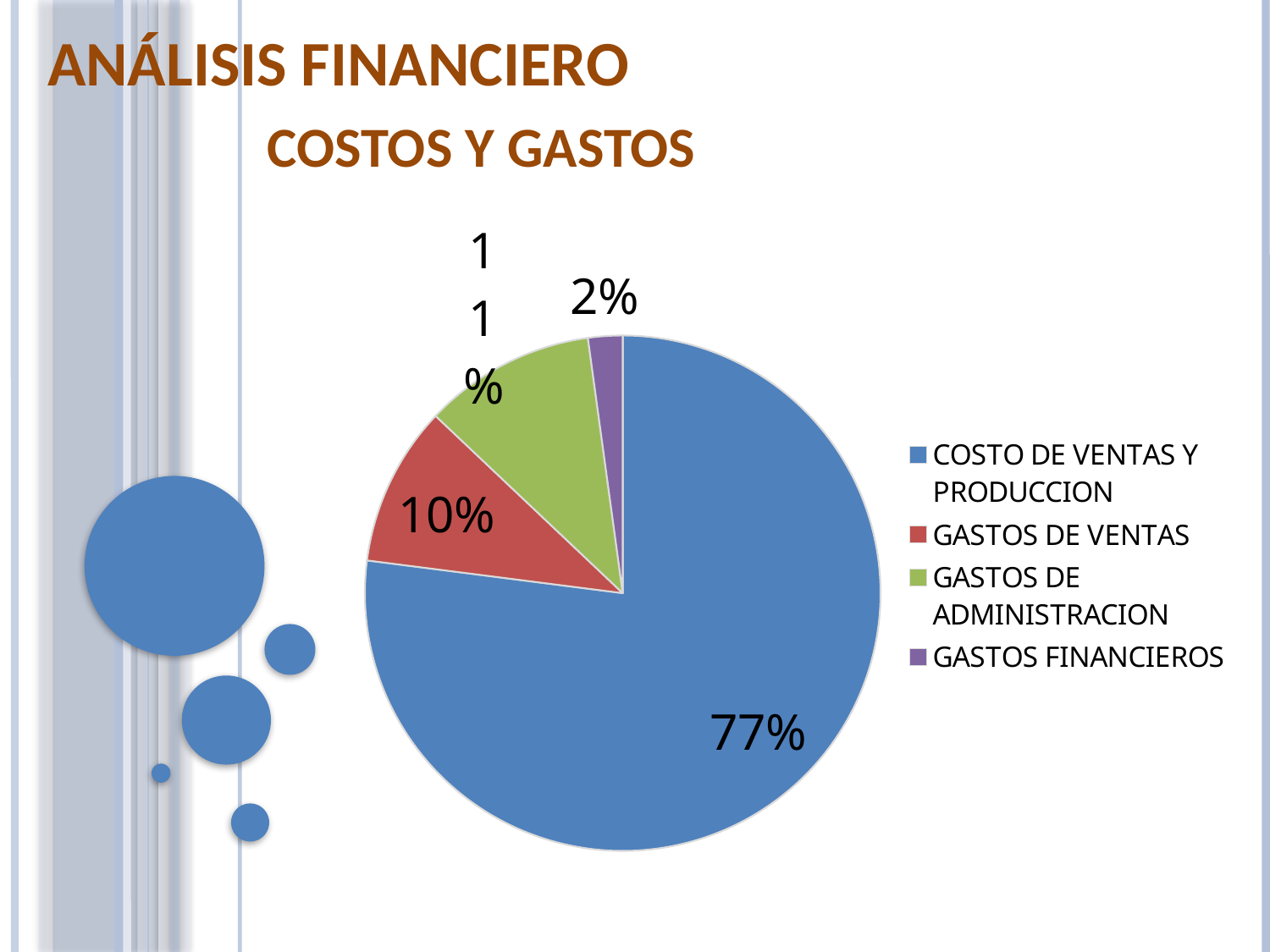
How many categories does the pie chart have? 4 Which category has the largest slice of the pie? COSTO DE VENTAS Y PRODUCCION Which is larger, the slice for GASTOS DE VENTAS or the slice for GASTOS FINANCIEROS? GASTOS DE VENTAS Which category has the smallest slice of the pie? GASTOS FINANCIEROS What colour is the slice for GASTOS DE ADMINISTRACION? green What share of the pie does GASTOS DE VENTAS represent? 10% What is the difference in percentage points between COSTO DE VENTAS Y PRODUCCION and GASTOS DE VENTAS? 67 What share of the pie does COSTO DE VENTAS Y PRODUCCION represent? 77% What share of the pie does GASTOS FINANCIEROS represent? 2% What is the title shown above the pie chart? COSTOS Y GASTOS What type of chart is shown on the slide? pie chart